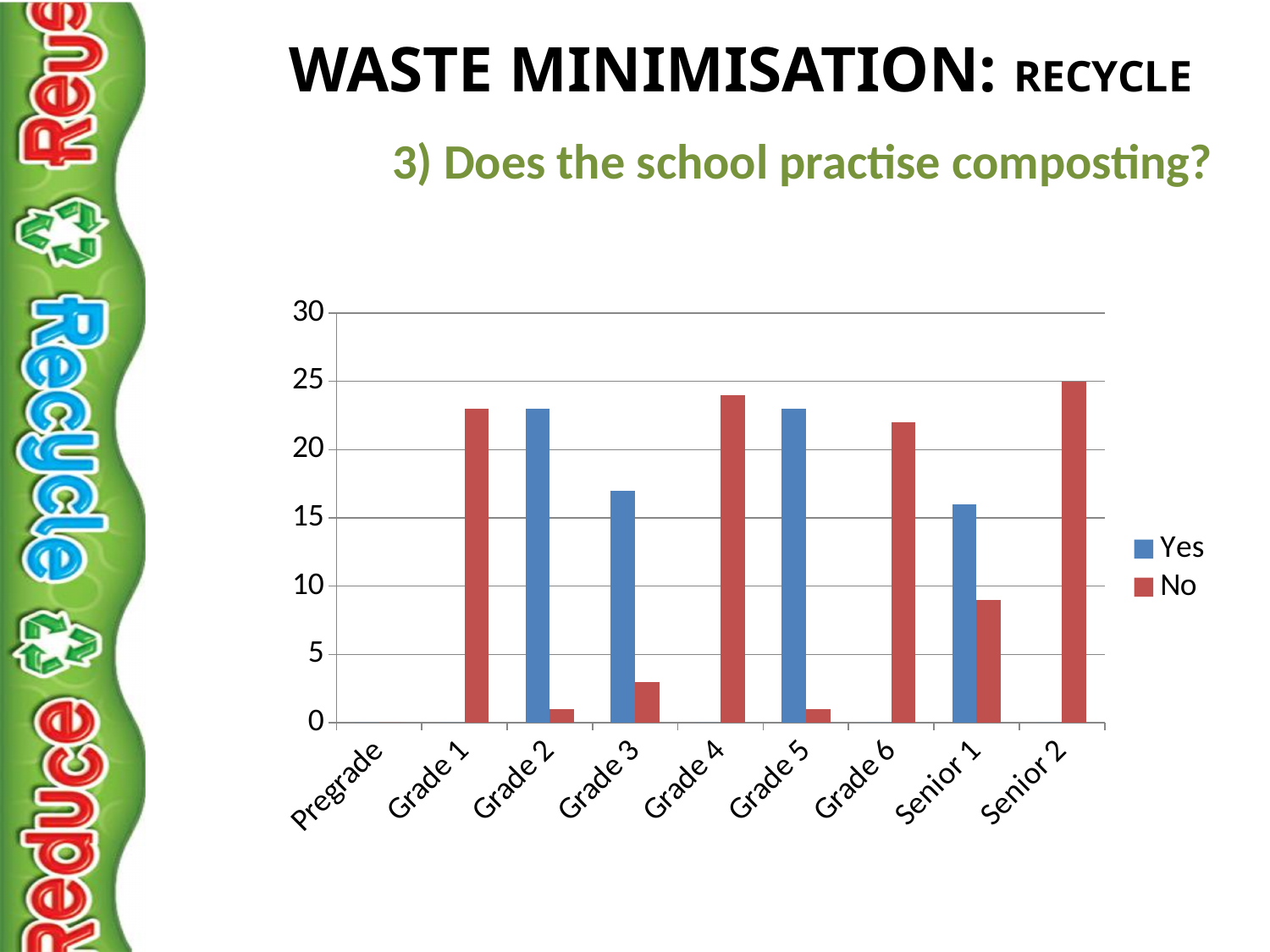
What kind of chart is shown on the slide? bar chart Is the value for No in Senior 1 greater or less than 10? less Is the value for Yes in Grade 3 greater or less than 15? greater In Senior 1, which is larger, Yes or No? Yes In Grade 3, which is larger, Yes or No? Yes How many series does the legend list? 2 Is the value for No in Grade 2 greater or less than 5? less What are the two entries in the legend? Yes and No How many categories are shown on the x axis? 9 Which category has no bars plotted? Pregrade